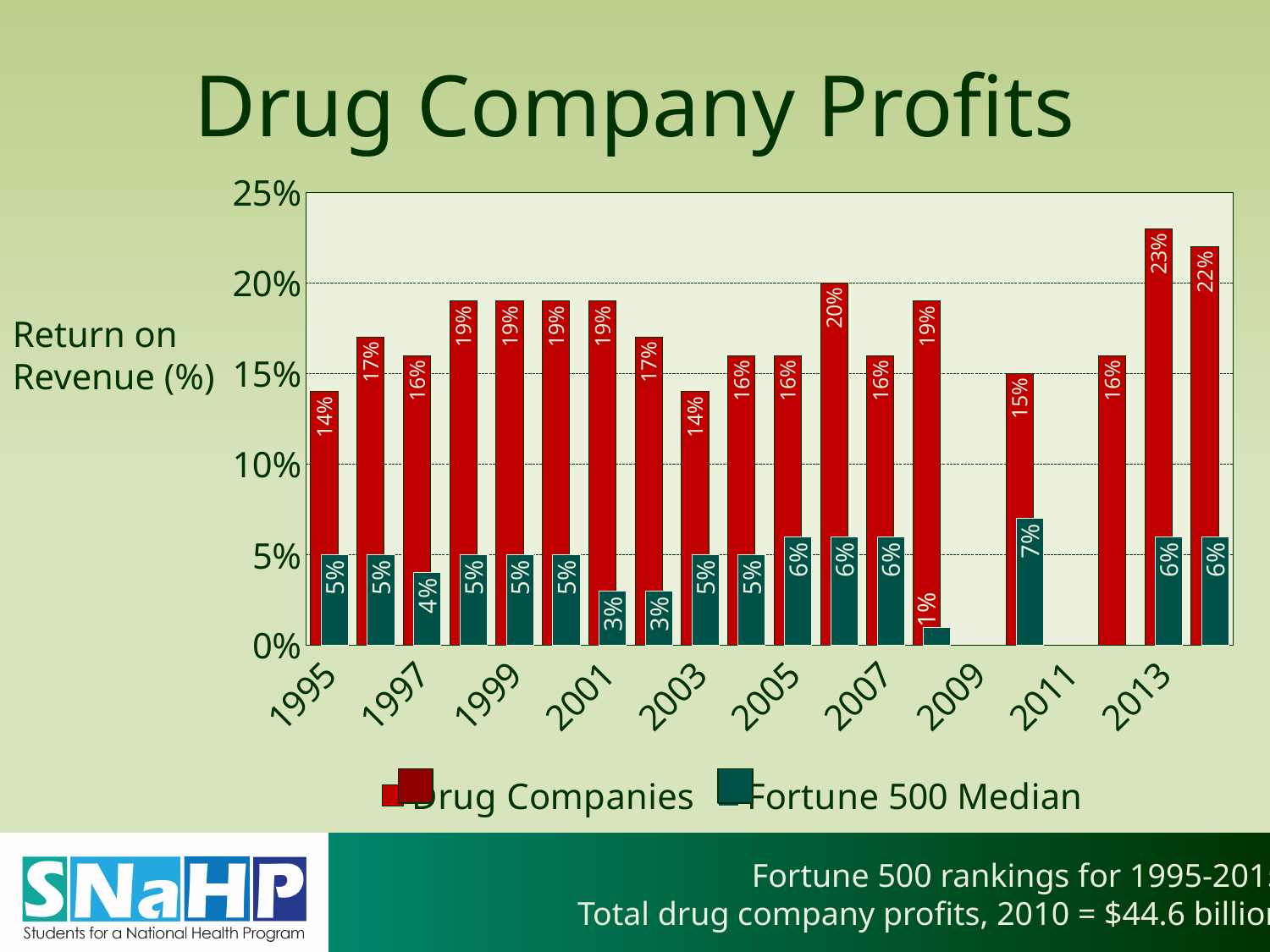
What is the return on revenue for Drug Companies in 1995? 14% What is the Fortune 500 Median return on revenue in 2001? 3% What are the two series named in the legend? Drug Companies and Fortune 500 Median How many series does the legend list? 2 What is the Fortune 500 Median return on revenue in 1997? 4% What is the difference between the Drug Companies and Fortune 500 Median values in 2013? 17 percentage points What is the return on revenue for Drug Companies in 2013? 23% What is the lowest Fortune 500 Median value shown on the chart? 1% Which is larger in 2003: the Drug Companies value or the Fortune 500 Median value? Drug Companies What type of chart is shown on the slide? bar chart Is the Drug Companies value for 2013 greater or less than 20%? greater In which year do Drug Companies have their highest return on revenue? 2013